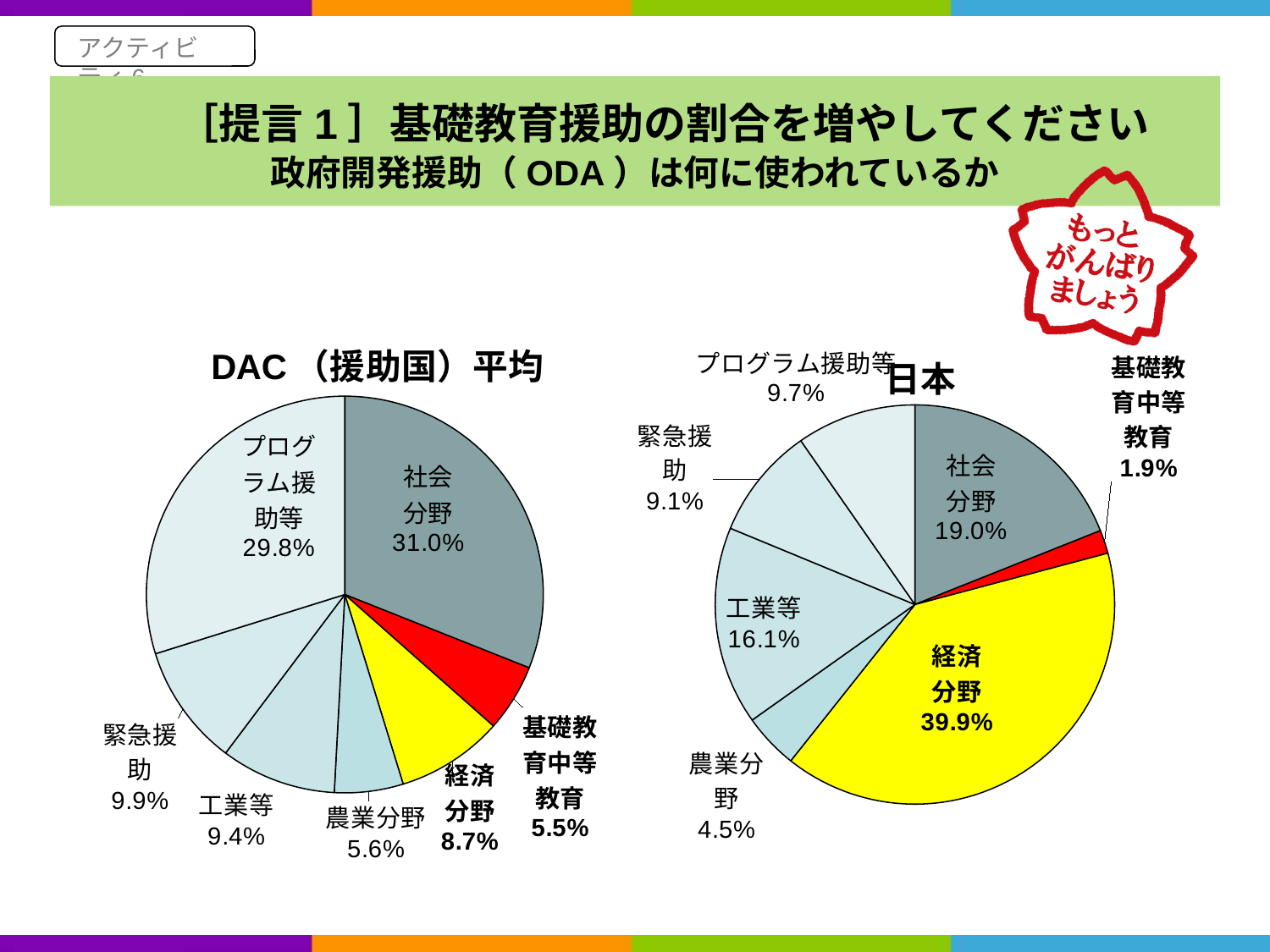
In the 日本 chart, what colour is the 経済分野 slice? Yellow In the DAC（援助国）平均 chart, what is the share for プログラム援助等? 29.8% How many slices does the DAC（援助国）平均 pie chart have? 7 What type of chart is the 日本 chart? Pie chart In the 日本 chart, which category has the largest share? 経済分野 What is the difference between the 基礎教育中等教育 share in the DAC（援助国）平均 chart and in the 日本 chart? 3.6% Which is larger: 工業等 in the DAC（援助国）平均 chart or 工業等 in the 日本 chart? 日本 In the DAC（援助国）平均 chart, what is the share for 社会分野? 31.0% In the 日本 chart, what is the share for 基礎教育中等教育? 1.9% In the DAC（援助国）平均 chart, which category has the largest share? 社会分野 In the 日本 chart, which category has the smallest share? 基礎教育中等教育 In the 日本 chart, what is the share for 経済分野? 39.9%